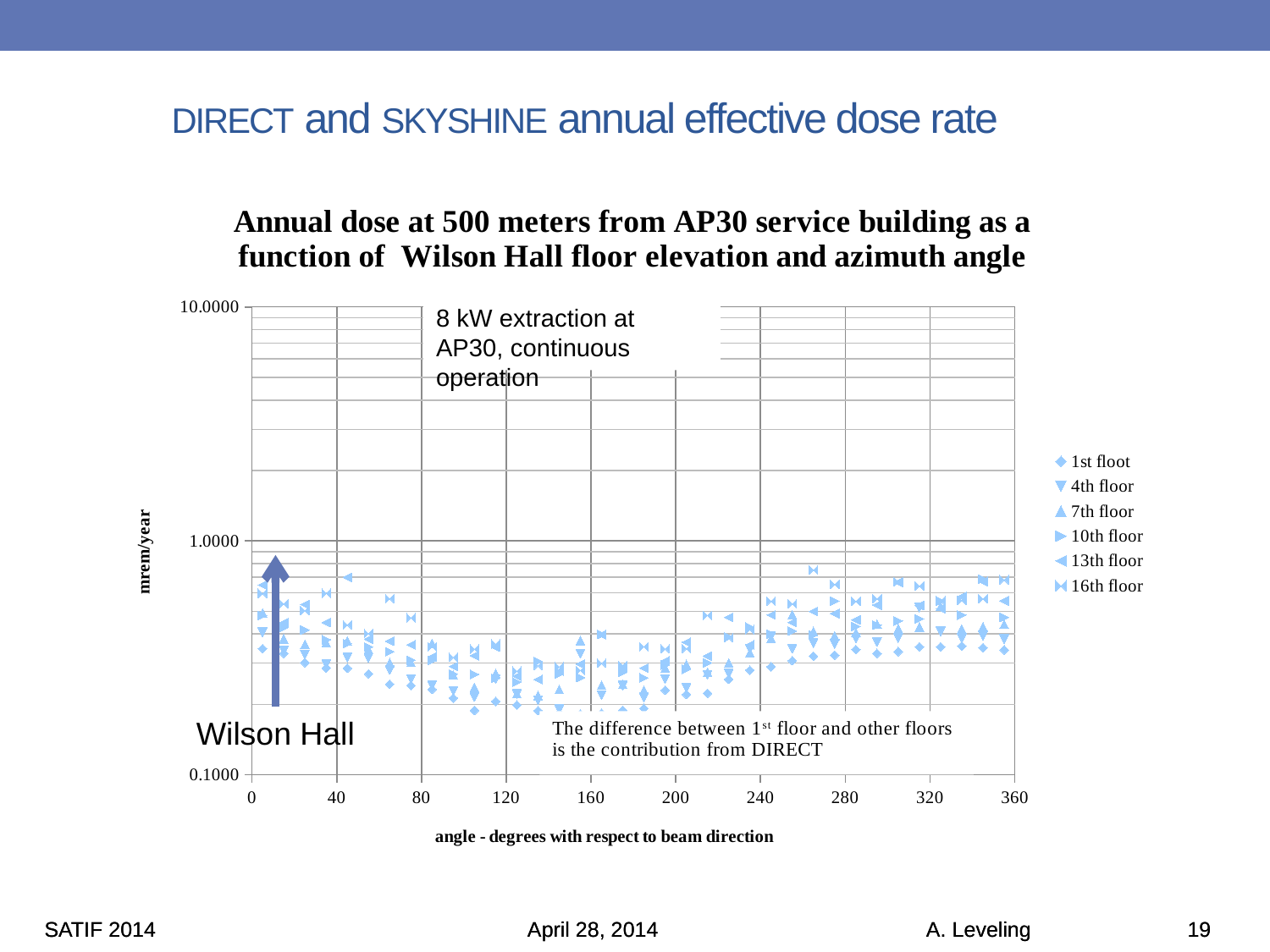
What is the title of the chart? Annual dose at 500 meters from AP30 service building as a function of Wilson Hall floor elevation and azimuth angle Are the plotted values at an angle of 160 degrees greater or less than 1.0000 mrem/year? less Do the plotted values generally rise or fall as the angle goes from 200 to 360 degrees? rise Are the plotted values at an angle of 280 degrees greater or less than 0.1000 mrem/year? greater Do the plotted values generally rise or fall as the angle goes from 0 to 120 degrees? fall What is the label of the y axis? mrem/year How many series does the chart legend list? 6 What is the maximum value shown on the x axis? 360 What kind of chart is shown on the slide? scatter chart Is the highest plotted value on the chart greater or less than 1.0000 mrem/year? less